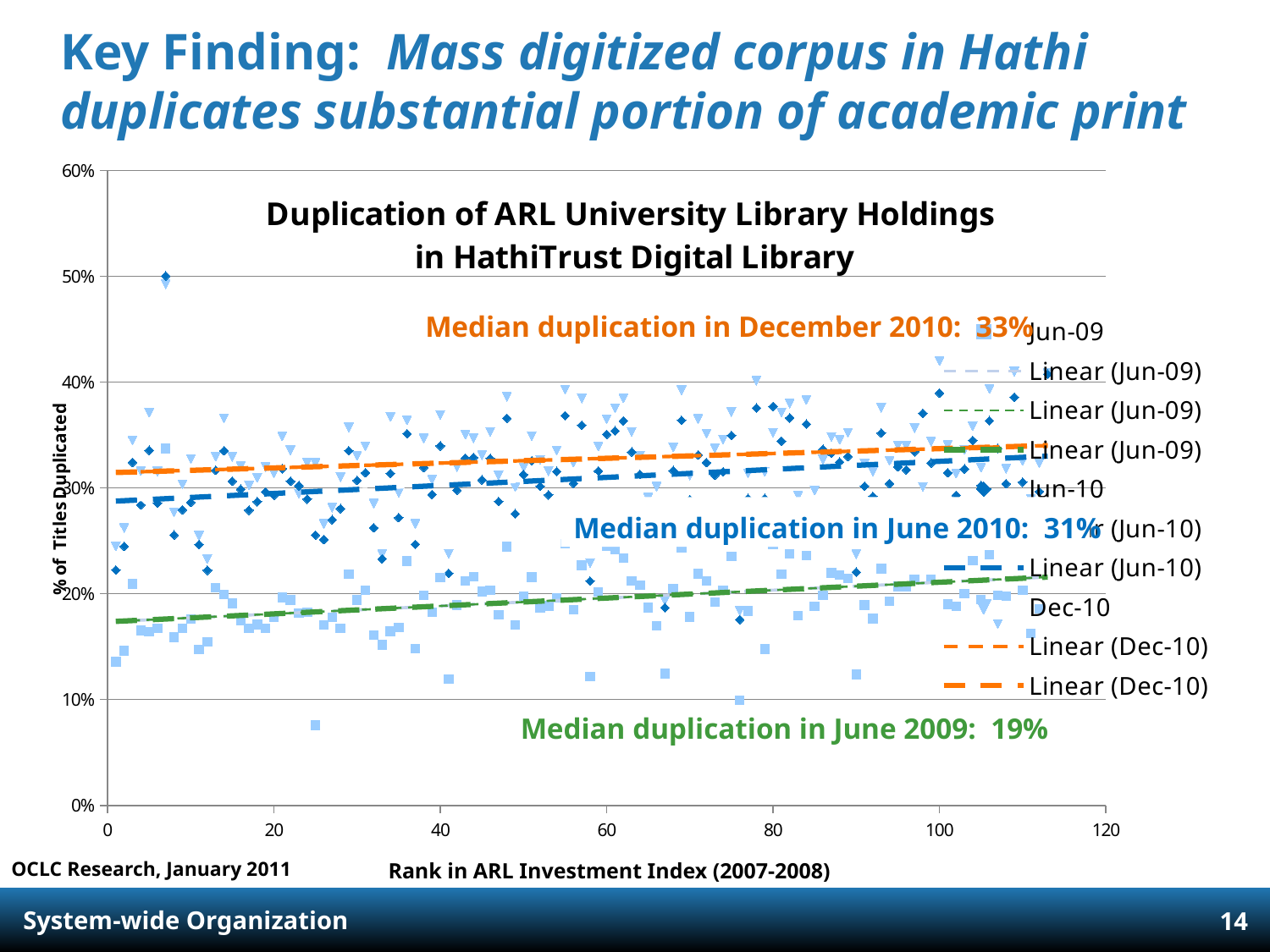
What is the label of the x axis? Rank in ARL Investment Index (2007-2008) What is the difference between the median duplication in December 2010 and in June 2009? 14 percentage points What is the title of the chart? Duplication of ARL University Library Holdings in HathiTrust Digital Library What is the median duplication in June 2010 according to the chart annotation? 31% Is the highest plotted point on the chart greater or less than 40%? greater Is the median duplication in June 2010 higher or lower than in December 2010? Lower What is the median duplication in December 2010 according to the chart annotation? 33% Do the linear trend lines rise or fall as the rank in the ARL Investment Index increases? Rise Which period has the highest median duplication shown on the chart? December 2010 What kind of chart is shown on the slide? Scatter chart What is the median duplication in June 2009 according to the chart annotation? 19% Which period has the lowest median duplication shown on the chart? June 2009